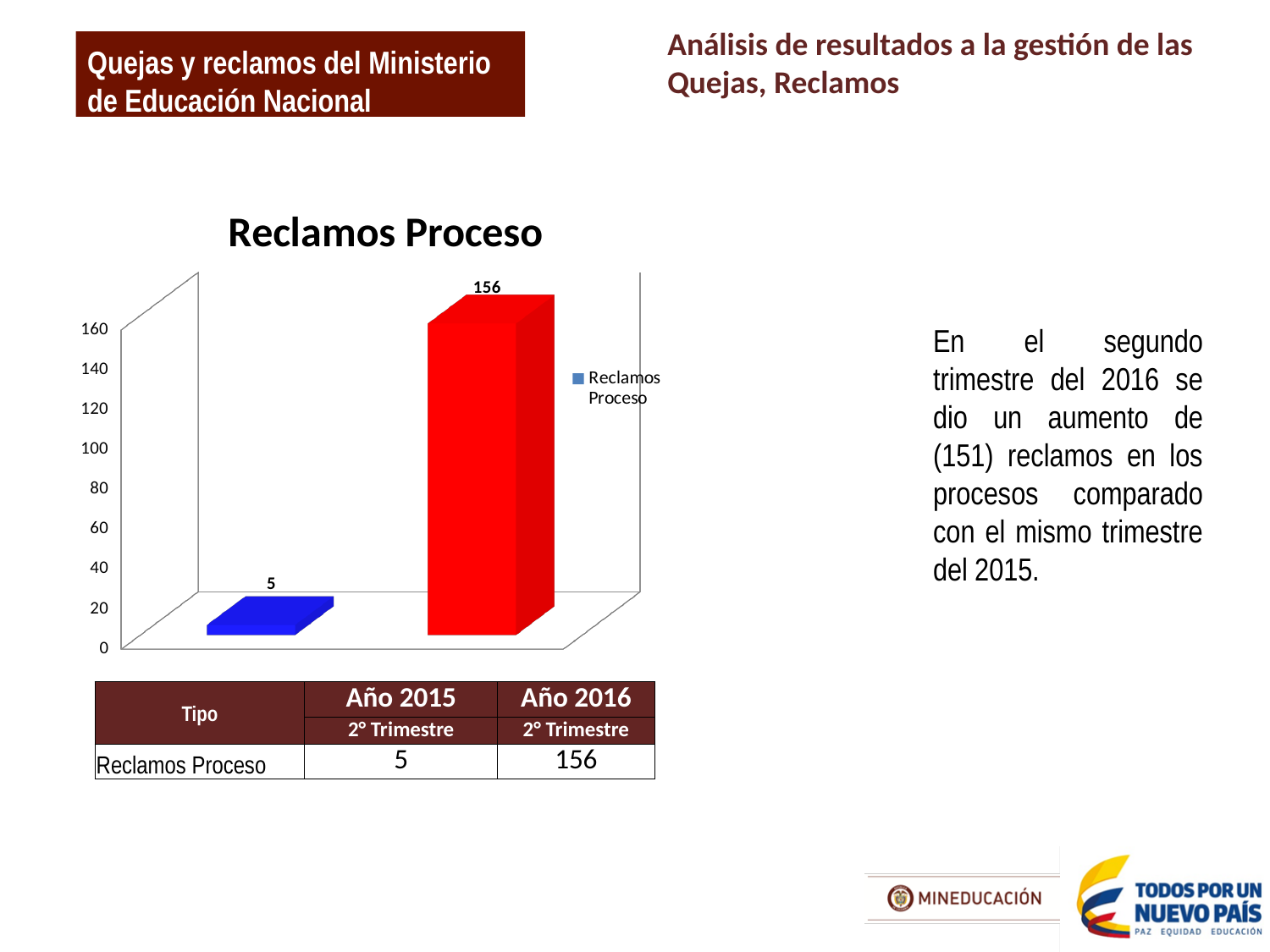
What is the value shown on the blue bar in the chart? 5 According to the table below the chart, what is the value of Reclamos Proceso for the 2° Trimestre of Año 2016? 156 Do the values rise or fall from the left bar to the right bar? rise What is the difference between the value of the red bar and the value of the blue bar? 151 Is the value of the red bar greater or less than 140? greater What is the title of the chart? Reclamos Proceso Which bar is the highest in the chart, the blue one or the red one? the red one How many series does the chart legend list? 1 What is the value shown on the red bar in the chart? 156 According to the table below the chart, what is the value of Reclamos Proceso for the 2° Trimestre of Año 2015? 5 What kind of chart is shown on the slide? bar chart How many bars are plotted in the chart? 2